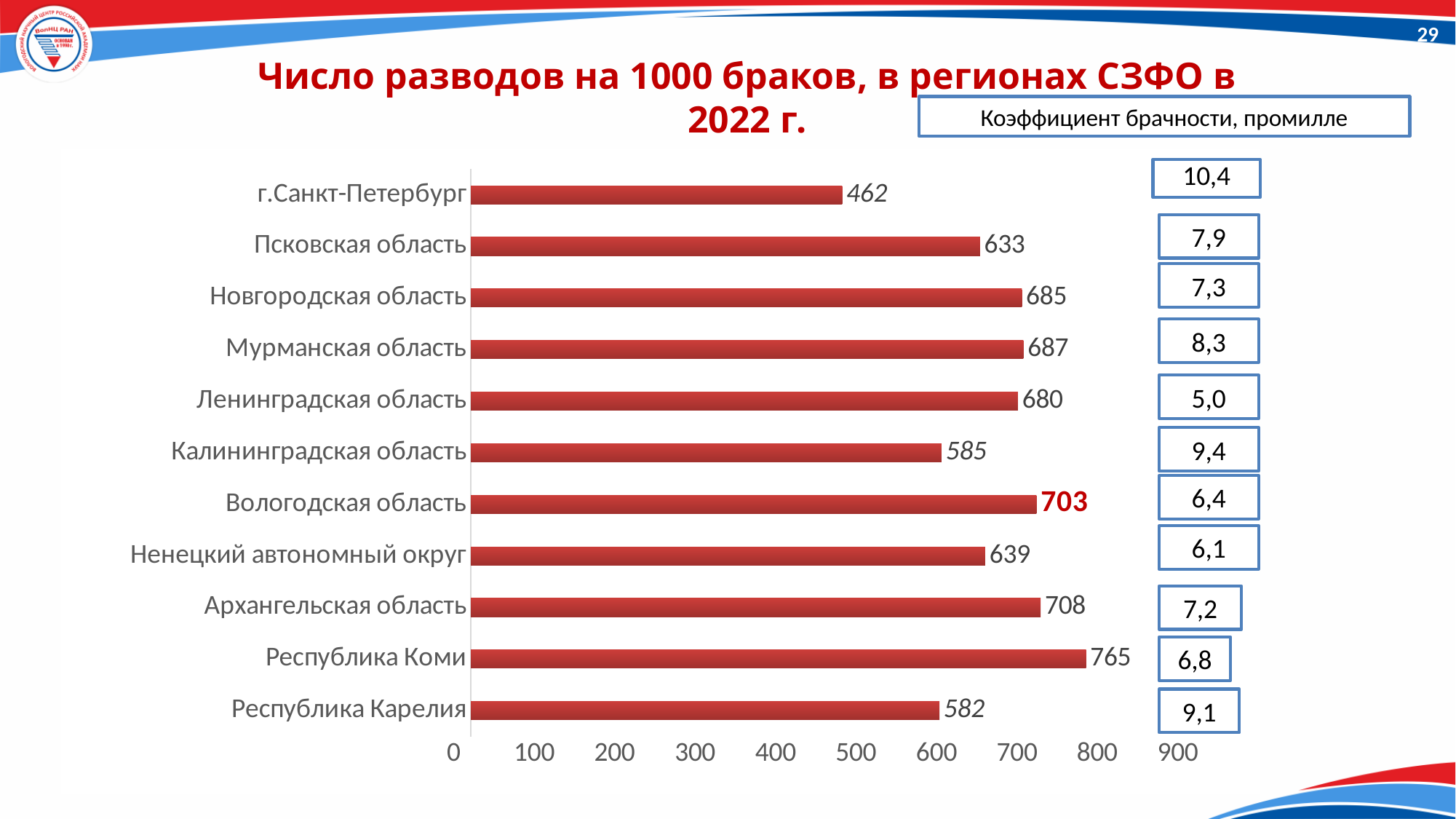
Which region has the lowest number of divorces per 1000 marriages? г.Санкт-Петербург What value is shown for г.Санкт-Петербург? 462 How many regions are shown in the chart? 11 What is the number of divorces per 1000 marriages for Вологодская область? 703 What type of chart is shown on the slide? Bar chart What is the difference between the values for Архангельская область and Вологодская область? 5 What value is shown for Ненецкий автономный округ? 639 What value is shown for Республика Карелия? 582 What is the difference between the values for Республика Коми and г.Санкт-Петербург? 303 What is the title of the chart? Число разводов на 1000 браков, в регионах СЗФО в 2022 г. Which has a larger value, Псковская область or Калининградская область? Псковская область Which region has the highest number of divorces per 1000 marriages? Республика Коми